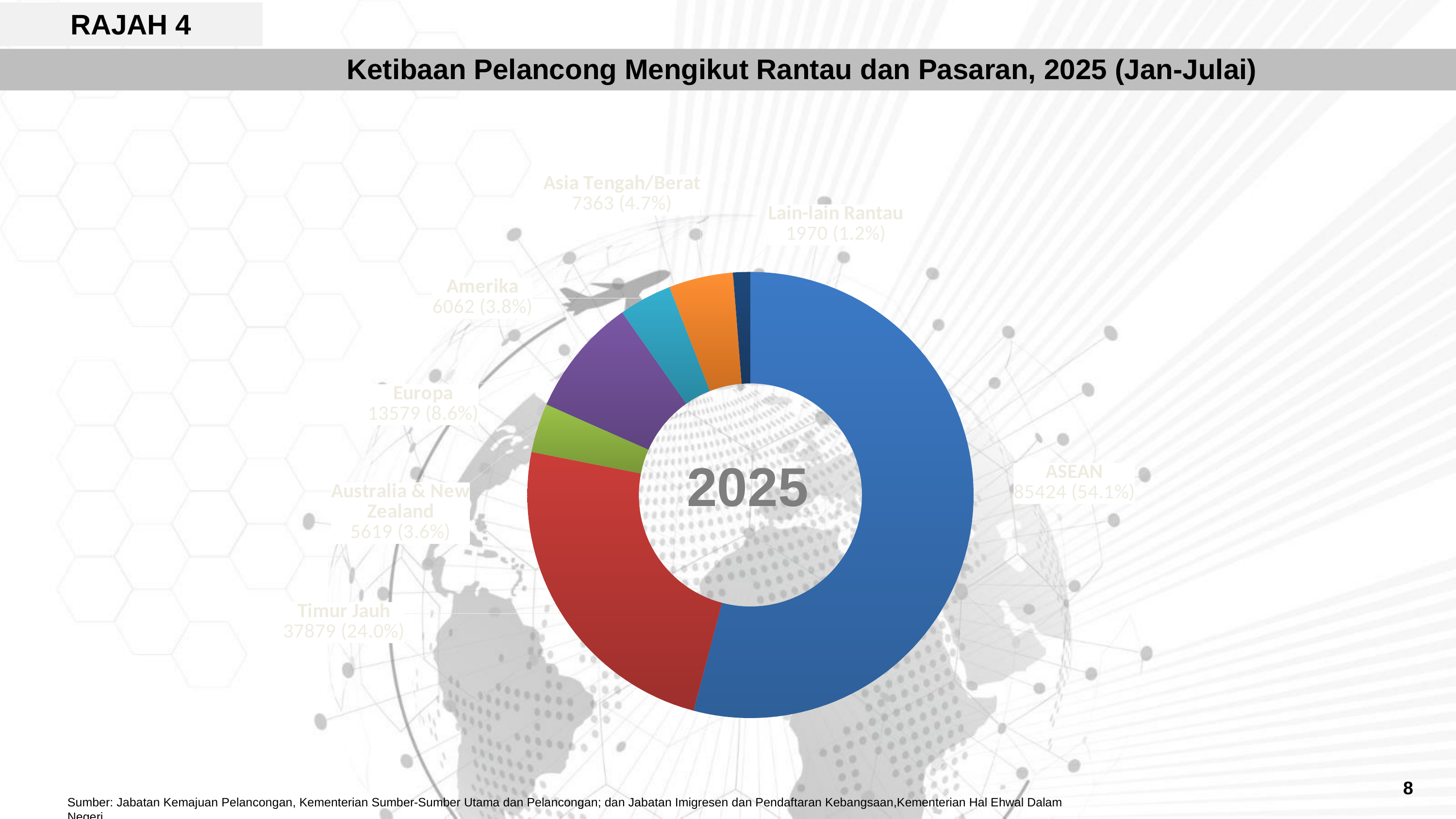
How many regions (categories) are shown in the chart? 7 Which region has the smallest share of tourist arrivals? Lain-lain Rantau What year is displayed in the centre of the donut chart? 2025 What is the value shown for ASEAN? 85424 (54.1%) Which region has the largest share of tourist arrivals? ASEAN What is the value shown for Timur Jauh? 37879 (24.0%) What is the difference between the values for ASEAN and Timur Jauh? 47545 What share of the chart does Asia Tengah/Berat represent? 4.7% Which is larger, the value for Amerika or the value for Australia & New Zealand? Amerika What kind of chart is shown on the slide? Pie chart (donut) What is the value shown for Europa? 13579 (8.6%) What is the share shown for Lain-lain Rantau? 1.2%